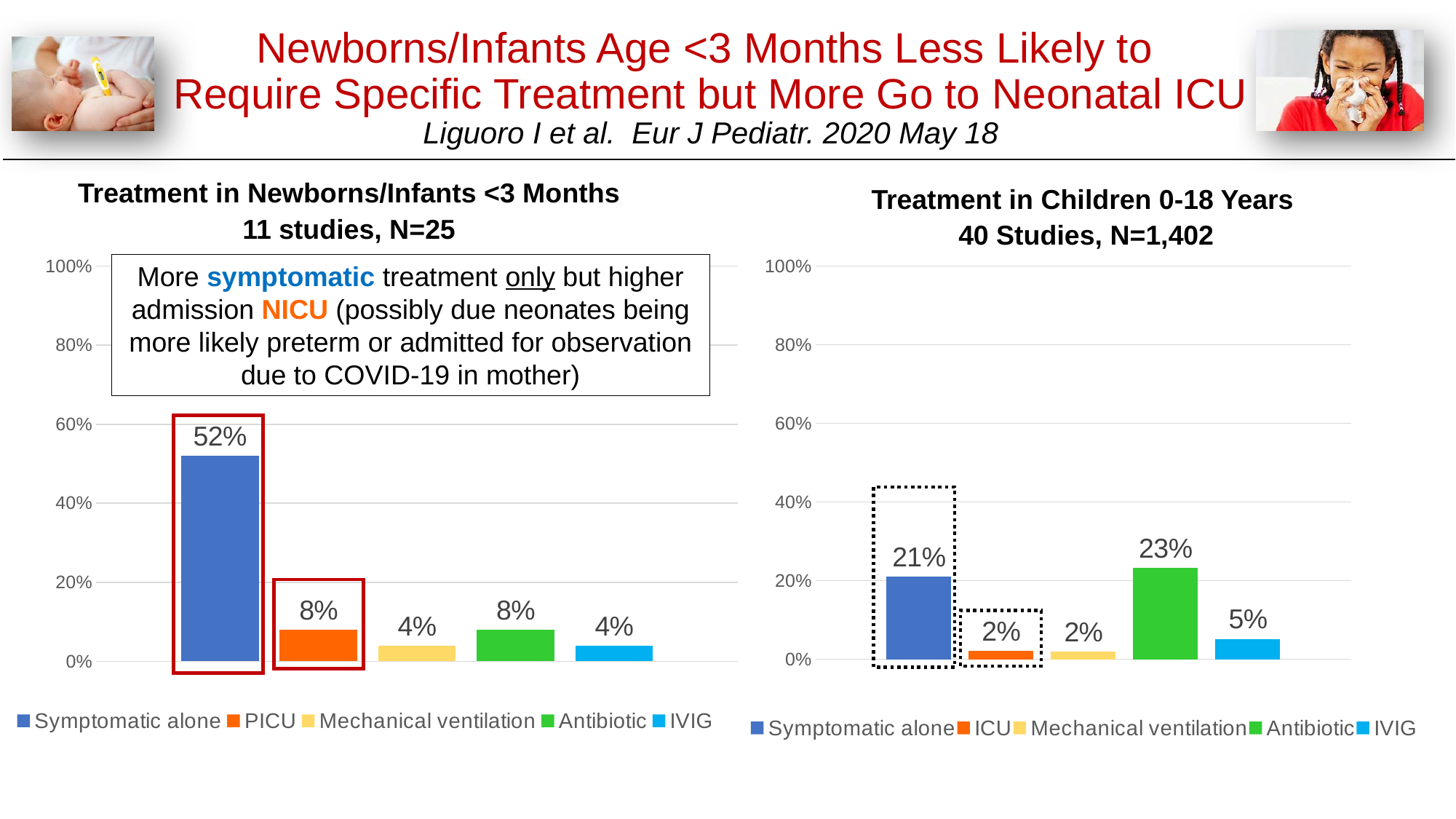
In the 'Treatment in Children 0-18 Years' chart, which category has the highest value? Antibiotic In the 'Treatment in Children 0-18 Years' chart, what is the difference between Antibiotic and Symptomatic alone? 2% In the 'Treatment in Newborns/Infants <3 Months' chart, what is the value for Symptomatic alone? 52% In the 'Treatment in Children 0-18 Years' chart, what is the value for Antibiotic? 23% In the 'Treatment in Newborns/Infants <3 Months' chart, what is the difference between Symptomatic alone and PICU? 44% In the 'Treatment in Newborns/Infants <3 Months' chart, which category has the highest value? Symptomatic alone What kind of chart is the 'Treatment in Newborns/Infants <3 Months' chart? Bar chart In the 'Treatment in Children 0-18 Years' chart, what is the value for IVIG? 5% Which is larger: Symptomatic alone in the 'Treatment in Newborns/Infants <3 Months' chart or Symptomatic alone in the 'Treatment in Children 0-18 Years' chart? Treatment in Newborns/Infants <3 Months In the 'Treatment in Newborns/Infants <3 Months' chart, is the value for Symptomatic alone greater or less than 40%? greater In the 'Treatment in Newborns/Infants <3 Months' chart, what is the value for PICU? 8% How many categories are shown in the 'Treatment in Children 0-18 Years' chart? 5